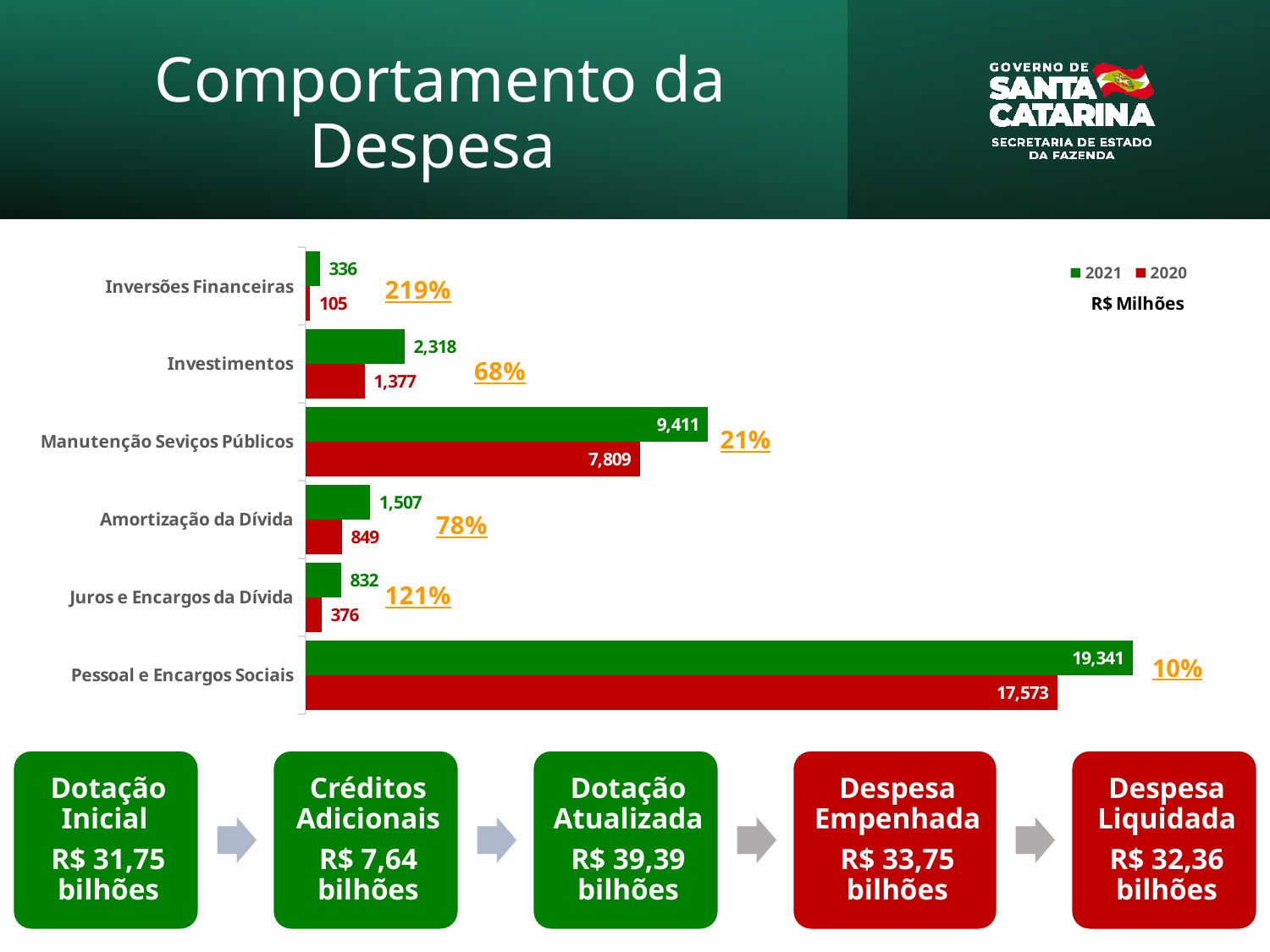
Which category has the lowest 2020 value? Inversões Financeiras How many categories are shown in the chart? 6 Which category has the highest 2021 value? Pessoal e Encargos Sociais What is the 2021 value for Inversões Financeiras? 336 How many series does the legend list? 2 Which is larger: the 2021 value for Amortização da Dívida or the 2021 value for Juros e Encargos da Dívida? Amortização da Dívida What is the 2020 value for Juros e Encargos da Dívida? 376 What kind of chart is shown on the slide? Bar chart What percentage change is shown next to the bars for Inversões Financeiras? 219% What is the difference between the 2021 and 2020 values for Pessoal e Encargos Sociais? 1,768 What is the difference between the 2021 and 2020 values for Investimentos? 941 What is the 2021 value for Manutenção Seviços Públicos? 9,411